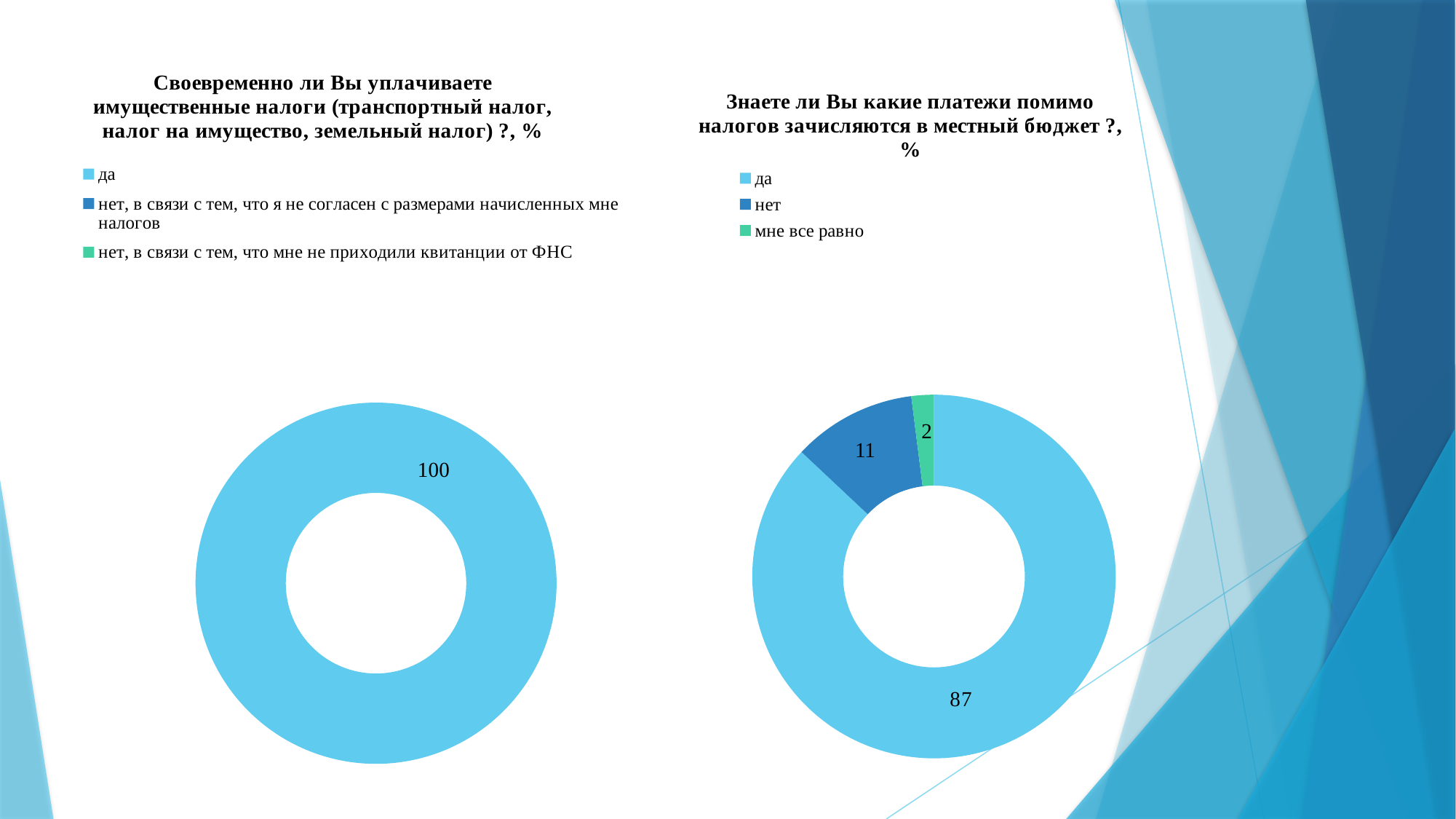
In the right-hand chart, which is larger: the value for "нет" or the value for "мне все равно"? нет In the right-hand chart, what is the value for "нет"? 11 In the right-hand chart ("Знаете ли Вы какие платежи помимо налогов зачисляются в местный бюджет ?, %"), what is the value for "да"? 87 In the right-hand chart, which category has the smallest value? мне все равно How many entries does the legend of the right-hand chart list? 3 In the left-hand chart ("Своевременно ли Вы уплачиваете имущественные налоги..."), what value is shown for "да"? 100 In the right-hand chart, what is the total of the three labelled values? 100 In the right-hand chart, what is the difference between the values for "да" and "нет"? 76 How many entries does the legend of the left-hand chart list? 3 In the right-hand chart, which category has the largest value? да In the right-hand chart, what is the value for "мне все равно"? 2 What type of chart is the left-hand chart? Doughnut chart